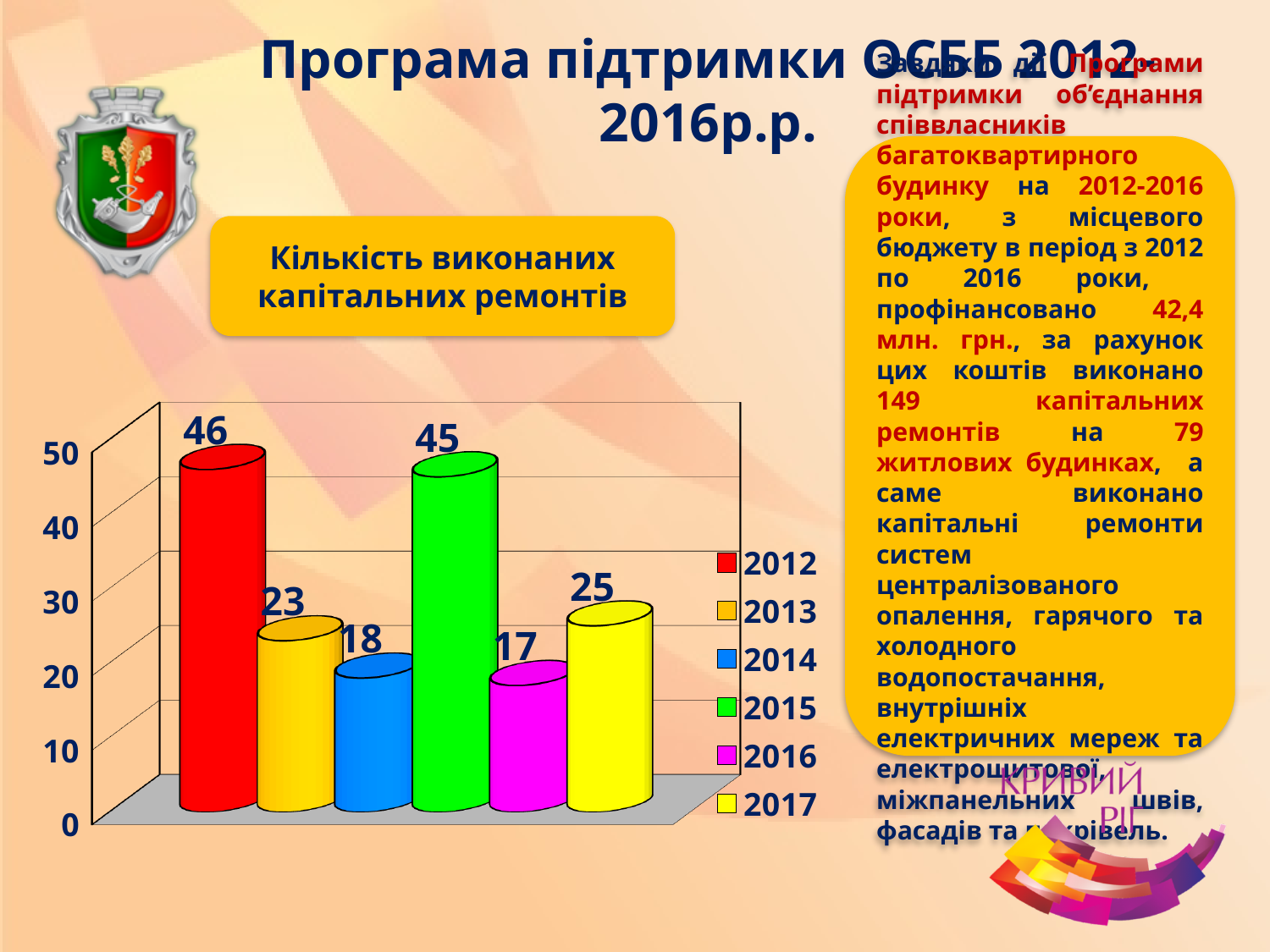
Which is larger, the value for 2013 or the value for 2014? 2013 Which year has the lowest value in the chart? 2016 What is the value for 2017 in the chart? 25 What is the difference between the values for 2012 and 2013? 23 What colour is the bar for 2015? green How many entries does the legend list? 6 What is the value for 2015 in the chart? 45 Which year has the highest value in the chart? 2012 What is the difference between the values for 2017 and 2014? 7 Is the value for 2015 greater or less than 40? greater What is the value for 2012 in the chart? 46 What kind of chart is shown on the slide? bar chart